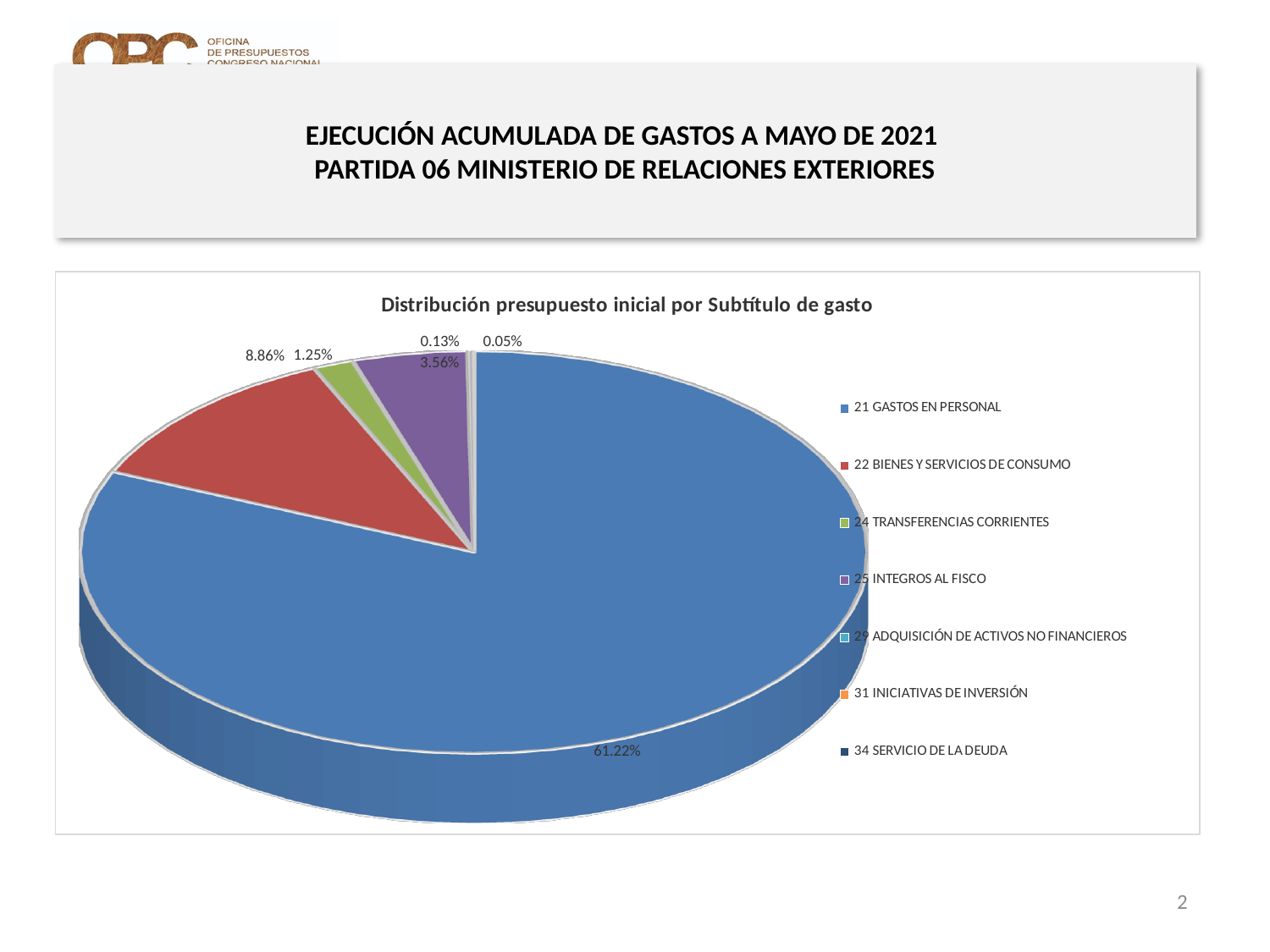
What percentage is shown for 22 BIENES Y SERVICIOS DE CONSUMO? 8.86% What is the difference in percentage points between 22 BIENES Y SERVICIOS DE CONSUMO and 24 TRANSFERENCIAS CORRIENTES? 7.61% How many entries does the chart legend list? 7 Which category has the largest slice of the pie? 21 GASTOS EN PERSONAL What percentage is shown for 25 INTEGROS AL FISCO? 3.56% What colour is the slice for 21 GASTOS EN PERSONAL? blue What is the title of the chart? Distribución presupuesto inicial por Subtítulo de gasto Which is larger, the slice for 22 BIENES Y SERVICIOS DE CONSUMO or the slice for 24 TRANSFERENCIAS CORRIENTES? 22 BIENES Y SERVICIOS DE CONSUMO What kind of chart is shown on the slide? pie chart What is the difference in percentage points between 25 INTEGROS AL FISCO and 24 TRANSFERENCIAS CORRIENTES? 2.31% What percentage is shown for 21 GASTOS EN PERSONAL? 61.22% What percentage is shown for 24 TRANSFERENCIAS CORRIENTES? 1.25%